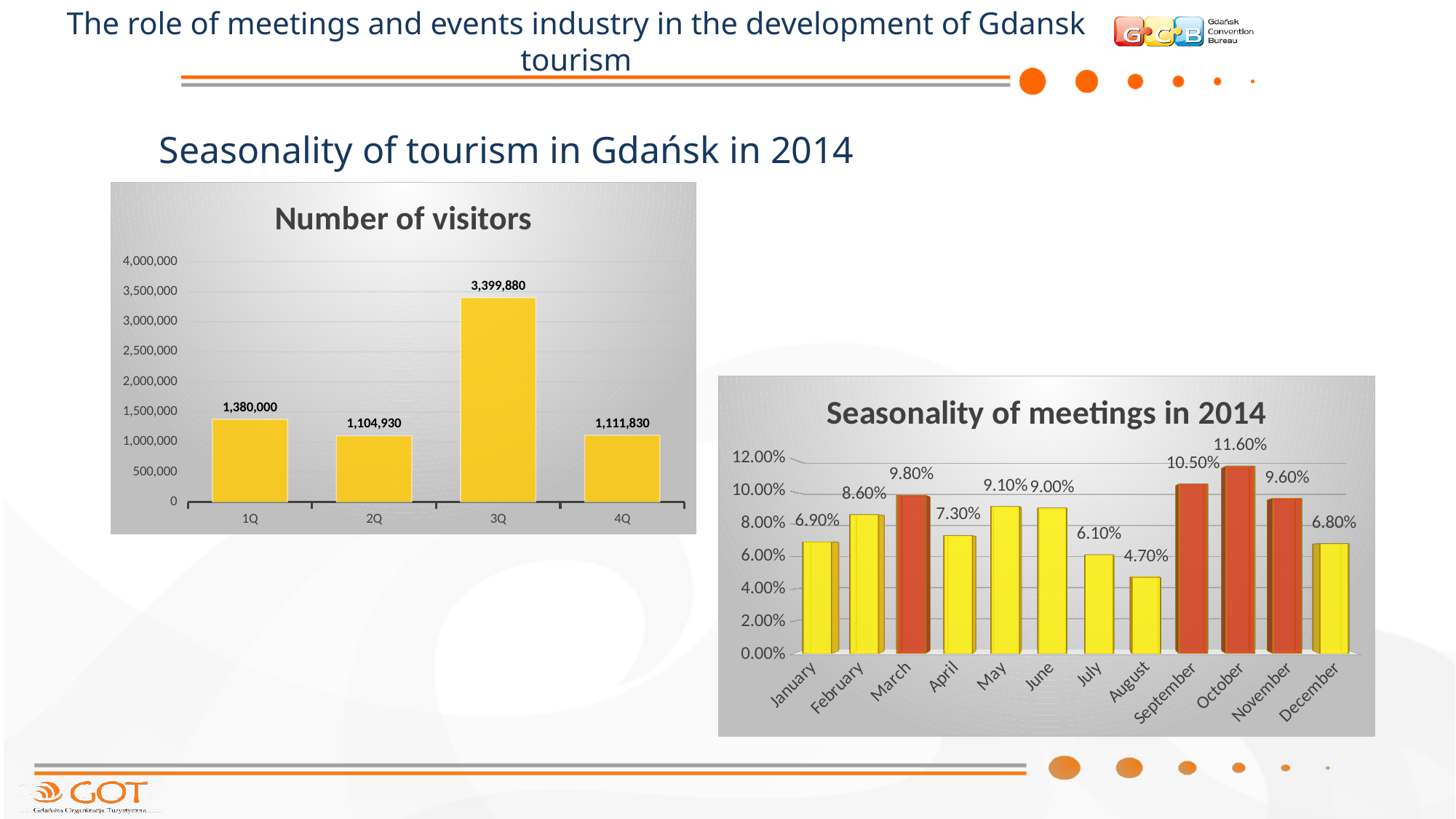
In the 'Number of visitors' chart, how many quarters are shown? 4 In the 'Number of visitors' chart, what is the difference between the values for 1Q and 4Q? 268,170 In the 'Seasonality of meetings in 2014' chart, what is the difference between the values for October and August? 6.90% In the 'Number of visitors' chart, which quarter has the lowest number of visitors? 2Q In the 'Seasonality of meetings in 2014' chart, what is the value for March? 9.80% In the 'Seasonality of meetings in 2014' chart, which month has the highest value? October What kind of chart is the 'Number of visitors' chart? bar chart In the 'Number of visitors' chart, what is the value for 3Q? 3,399,880 In the 'Seasonality of meetings in 2014' chart, which month has the lowest value? August In the 'Seasonality of meetings in 2014' chart, is the value for September larger or the value for November? September In the 'Seasonality of meetings in 2014' chart, which months are shown with red bars? March, September, October, November In the 'Seasonality of meetings in 2014' chart, how many months are shown? 12